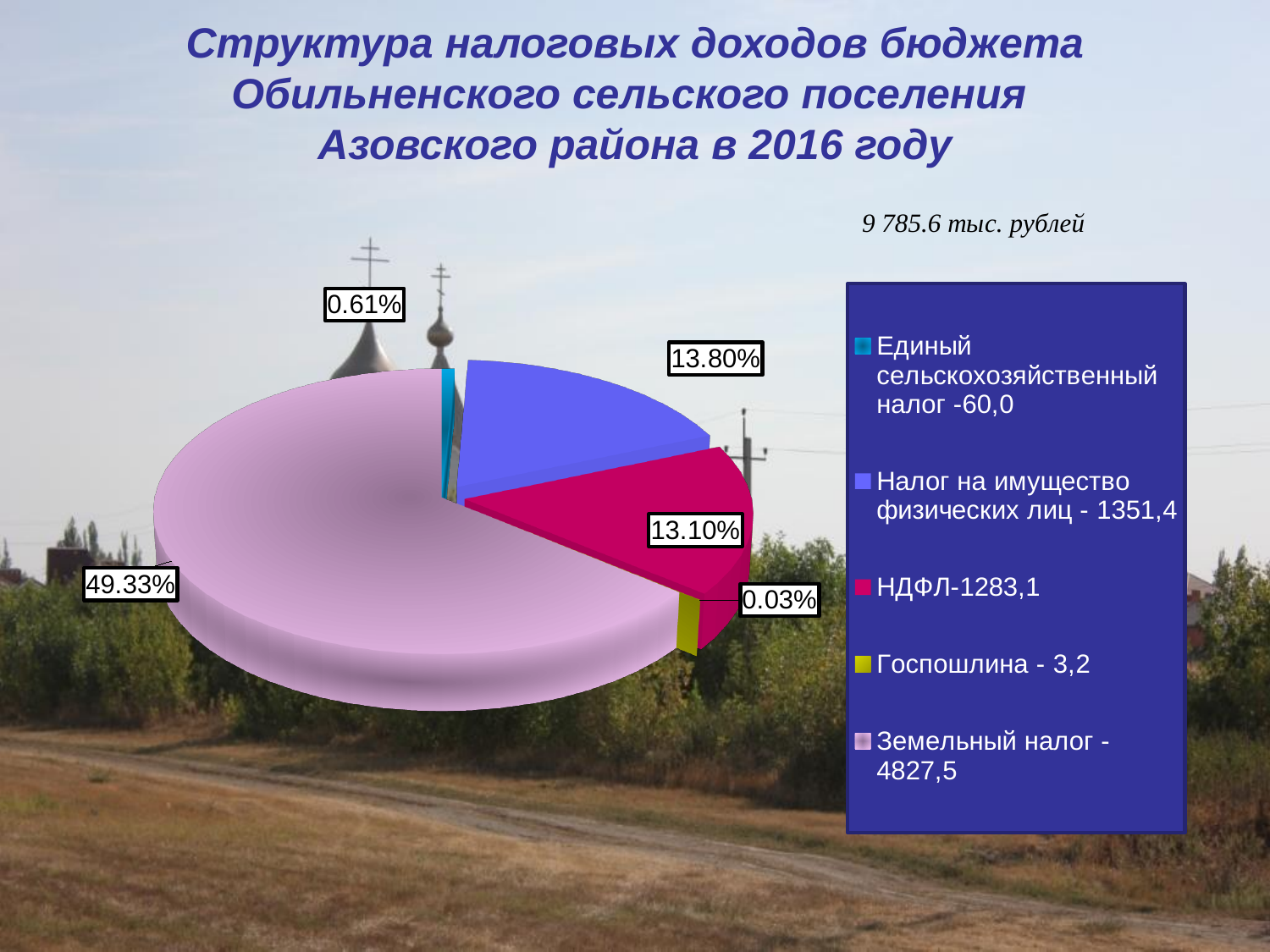
Which category has the largest slice of the pie? Земельный налог How many entries does the legend list? 5 What kind of chart is shown on the slide? pie chart What share of the pie does Госпошлина have? 0.03% What amount is given in the legend for Единый сельскохозяйственный налог? 60,0 Which is larger: the share for Налог на имущество физических лиц or the share for НДФЛ? Налог на имущество физических лиц How many slices does the pie chart have? 5 What share of the pie does Земельный налог have? 49.33% Which category has the smallest slice of the pie? Госпошлина What share of the pie does НДФЛ have? 13.10% What is the difference between the share for Налог на имущество физических лиц and the share for НДФЛ? 0.70%